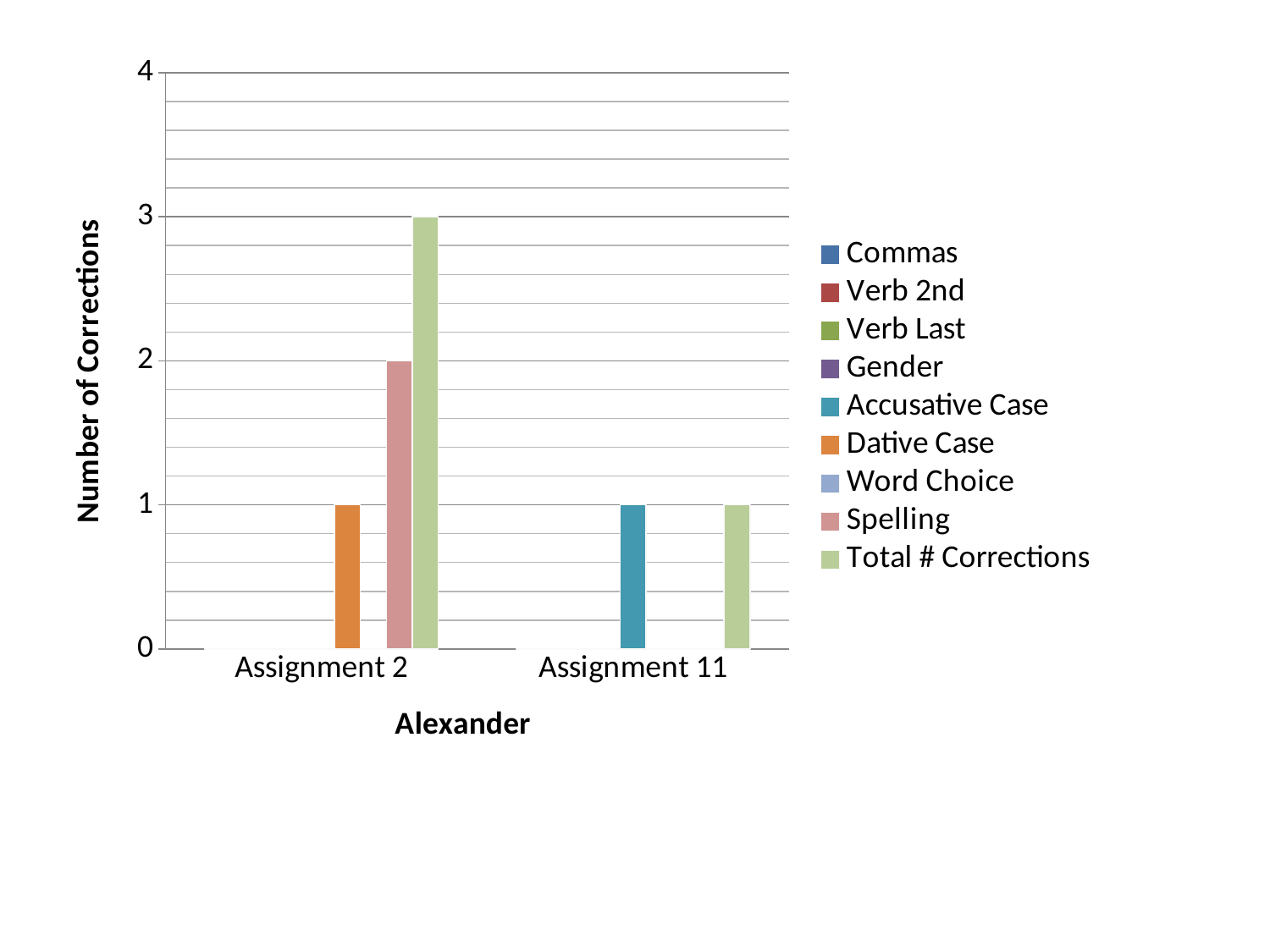
What type of chart is shown on the slide? bar chart What is the value of Total # Corrections for Assignment 2? 3 What is the value of Dative Case for Assignment 2? 1 Does the Total # Corrections fall or rise from Assignment 2 to Assignment 11? fall How many assignment categories are shown on the x axis? 2 Which assignment has the higher Total # Corrections? Assignment 2 What is the value of Total # Corrections for Assignment 11? 1 How many series does the legend list? 9 What is the value of Accusative Case for Assignment 11? 1 What is the label of the y axis? Number of Corrections What is the value of Spelling for Assignment 2? 2 What is the difference in Total # Corrections between Assignment 2 and Assignment 11? 2